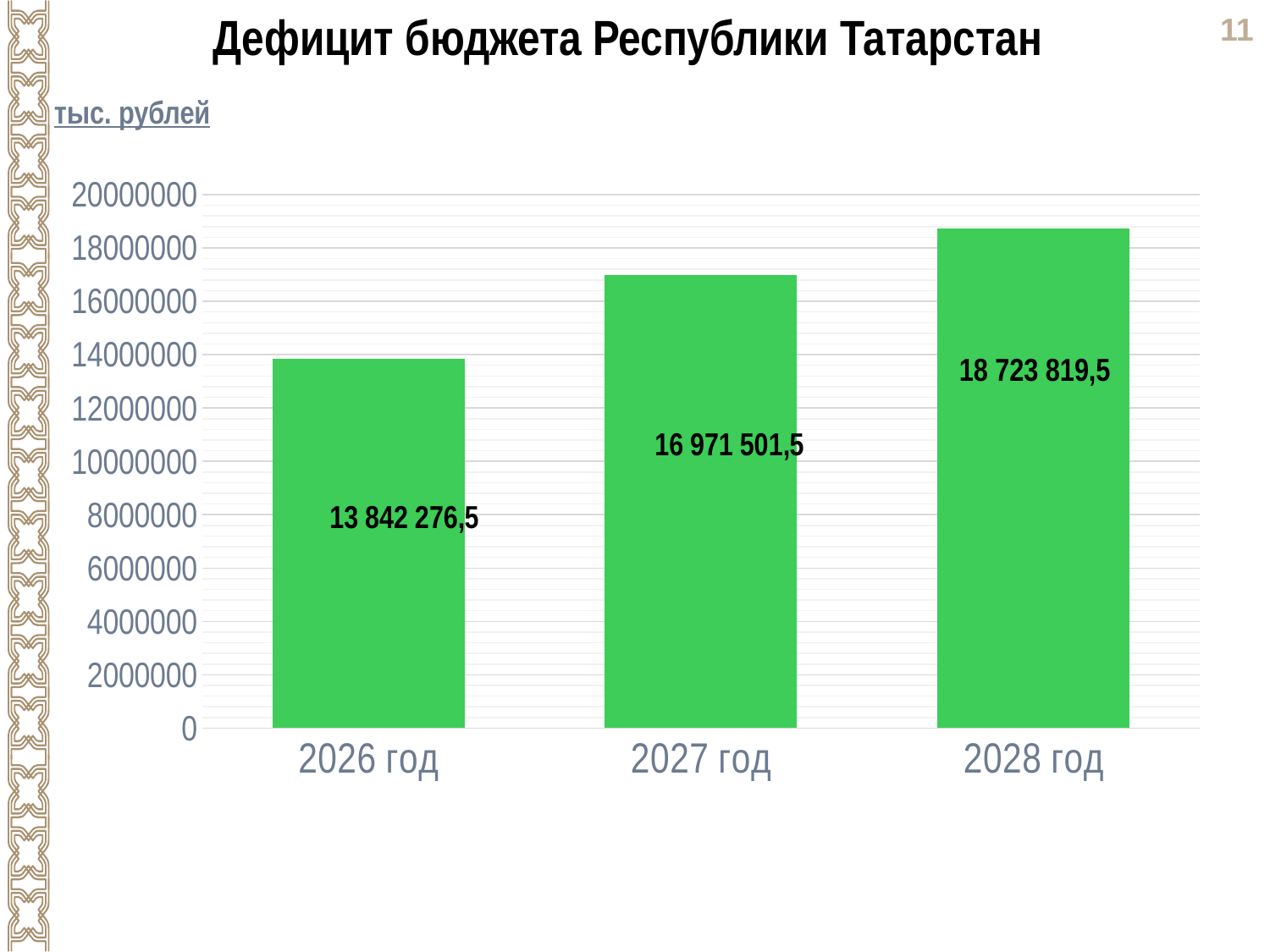
What is the value for 2028 год? 18 723 819,5 What is the difference between the values for 2027 год and 2026 год? 3 129 225,0 How many years are shown on the chart? 3 What is the value for 2026 год? 13 842 276,5 What is the difference between the values for 2028 год and 2027 год? 1 752 318,0 Do the values rise or fall from 2026 год to 2028 год? rise Which year has the highest value? 2028 год Is the value for 2026 год greater or less than 12000000? greater What is the value for 2027 год? 16 971 501,5 Which is larger, the value for 2027 год or the value for 2028 год? 2028 год What kind of chart is shown on the slide? bar chart Which year has the lowest value? 2026 год